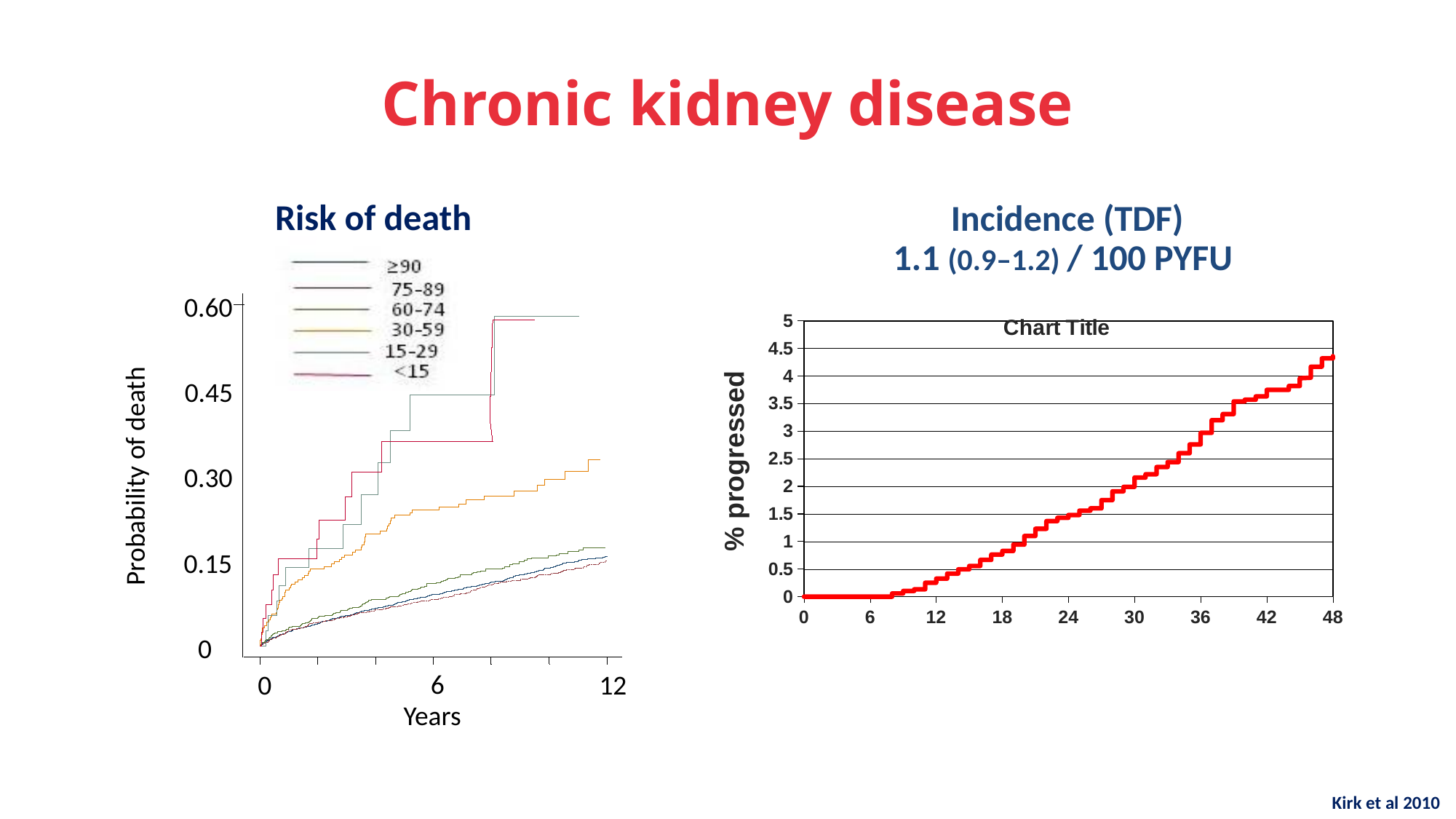
In the 'Incidence (TDF)' chart, is the value at 48 on the x axis greater or less than 4? greater In the 'Risk of death' chart, is the probability of death for the ≥90 group at 12 years greater or less than 0.30? less In the 'Incidence (TDF)' chart, what is the % progressed at 6 on the x axis? 0 What kind of chart is the 'Incidence (TDF)' chart on the right? line chart In the 'Risk of death' chart, at 12 years, which group has the higher probability of death: 30-59 or 60-74? 30-59 What kind of chart is the 'Risk of death' chart on the left? line chart In the 'Risk of death' chart, is the probability of death for the 15-29 group at 12 years greater or less than 0.45? greater In the 'Incidence (TDF)' chart, does the % progressed rise or fall as the x axis increases? rise In the 'Risk of death' chart, what is the label of the y axis? Probability of death In the 'Risk of death' chart, how many series does the legend list? 6 In the 'Incidence (TDF)' chart, what is the label of the y axis? % progressed